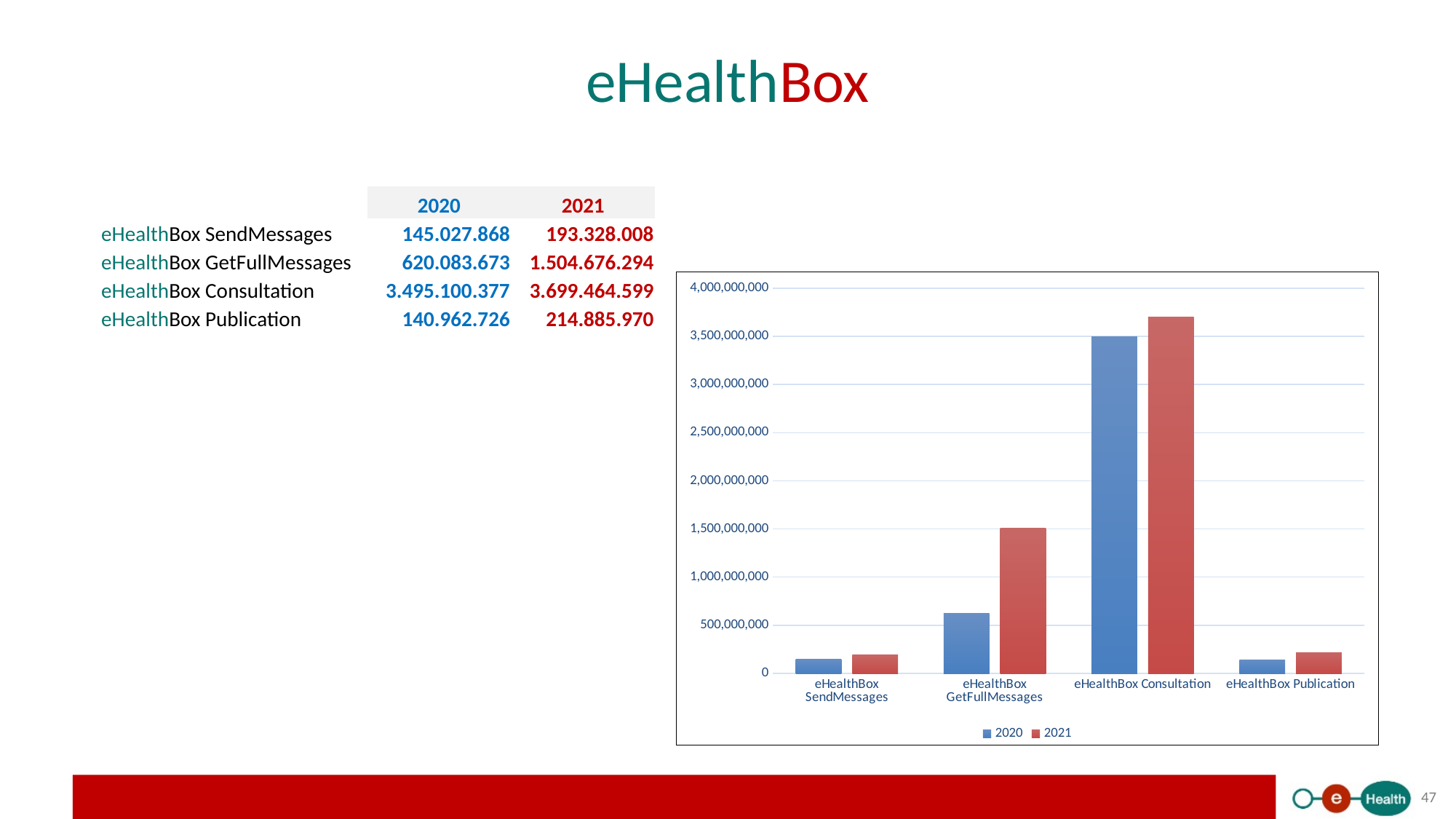
How many categories are shown on the x axis of the chart? 4 How many series does the chart legend list? 2 Which is larger for eHealthBox GetFullMessages, the 2020 value or the 2021 value? 2021 Is the 2021 value for eHealthBox Consultation greater or less than 3,500,000,000? greater Which category has the lowest 2020 value? eHealthBox Publication What is the 2020 value for eHealthBox Consultation? 3.495.100.377 Which colour represents the 2021 series in the chart? red What is the 2021 value for eHealthBox Publication? 214.885.970 What is the 2021 value for eHealthBox GetFullMessages? 1.504.676.294 What kind of chart is shown on the slide? bar chart What is the difference between the 2021 and 2020 values for eHealthBox SendMessages? 48.300.140 Which category has the highest 2021 value? eHealthBox Consultation